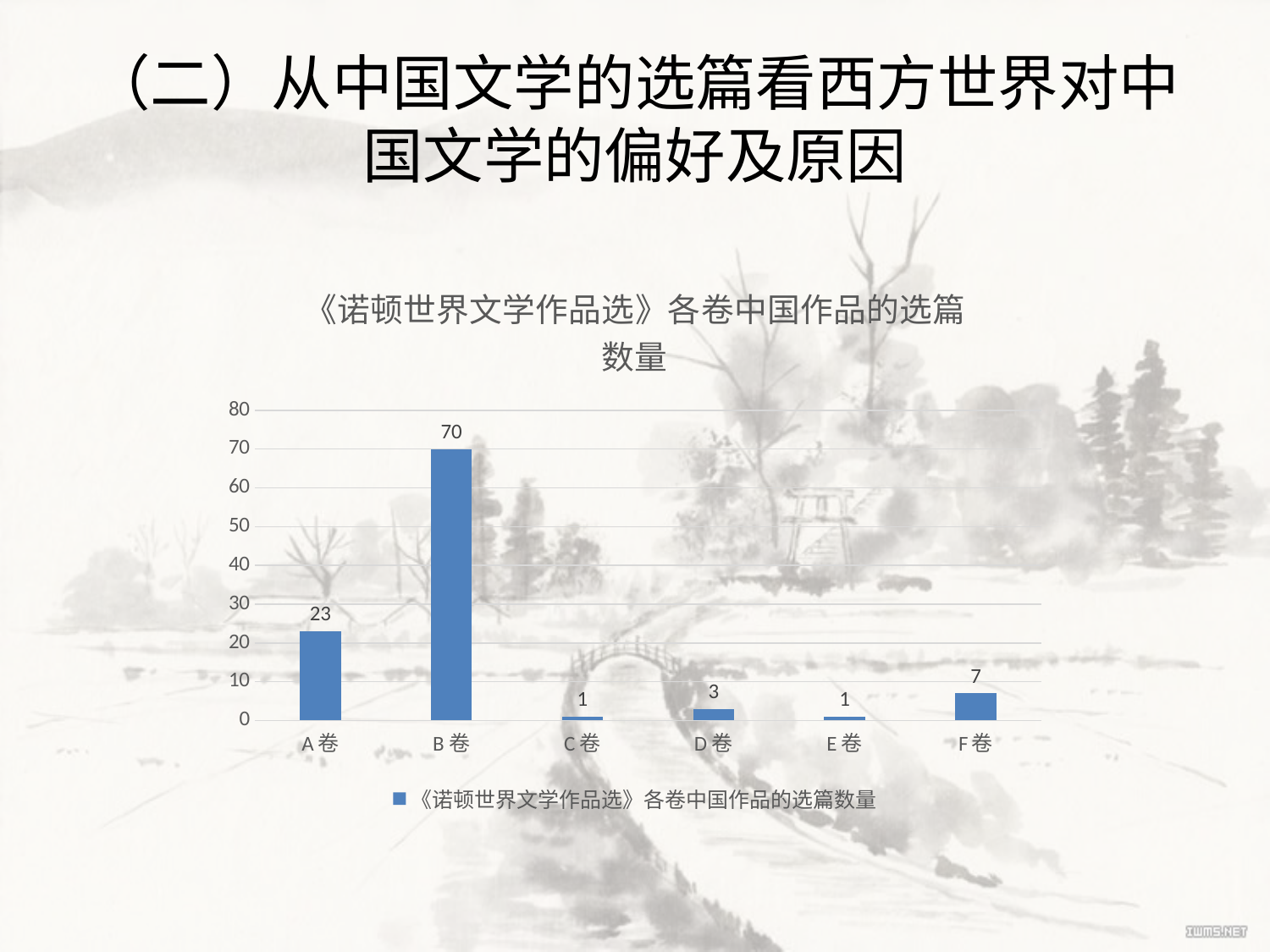
What is the value for A 卷? 23 Which category has the highest value? B 卷 What kind of chart is shown? bar chart How many series does the legend list? 1 What is the difference between the values for B 卷 and A 卷? 47 What is the title of the chart? 《诺顿世界文学作品选》各卷中国作品的选篇数量 What is the value for D 卷? 3 What is the value for B 卷? 70 How many categories are shown on the x axis? 6 What is the value for F 卷? 7 Is the value for A 卷 greater or less than 20? greater Which is larger, the value for F 卷 or the value for D 卷? F 卷